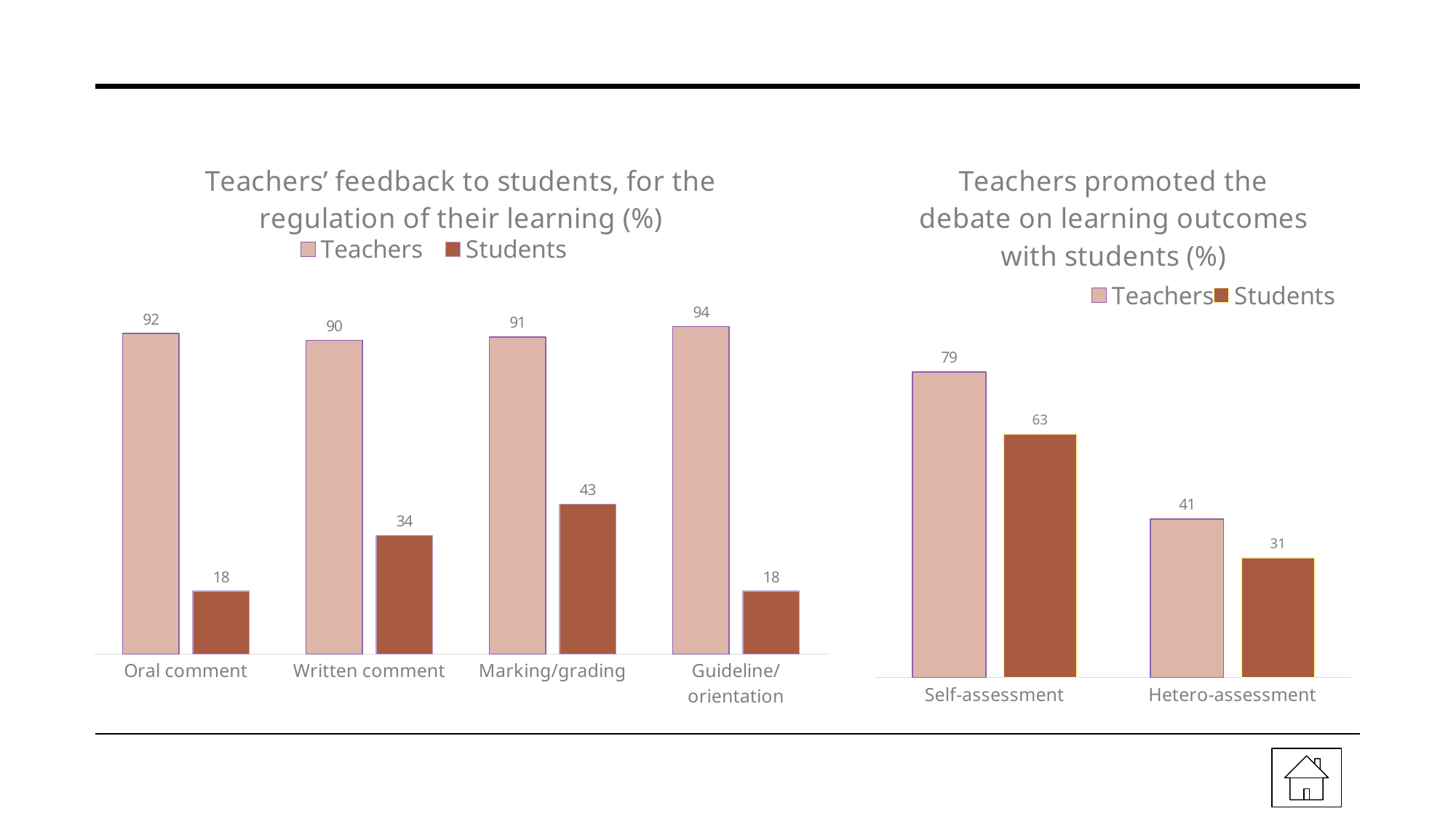
In the chart 'Teachers promoted the debate on learning outcomes with students (%)', what is the difference between the Teachers and Students values for Self-assessment? 16 In the chart 'Teachers' feedback to students, for the regulation of their learning (%)', what is the difference between the Teachers and Students values for Written comment? 56 In the chart 'Teachers' feedback to students, for the regulation of their learning (%)', how many categories are shown on the x axis? 4 In the chart 'Teachers' feedback to students, for the regulation of their learning (%)', which category has the highest Teachers value? Guideline/orientation In the chart 'Teachers promoted the debate on learning outcomes with students (%)', which is larger: the Students value for Self-assessment or the Teachers value for Hetero-assessment? Students value for Self-assessment In the chart 'Teachers' feedback to students, for the regulation of their learning (%)', what is the Students value for Marking/grading? 43 In the chart 'Teachers promoted the debate on learning outcomes with students (%)', what is the Teachers value for Hetero-assessment? 41 In the chart 'Teachers' feedback to students, for the regulation of their learning (%)', what is the Teachers value for Oral comment? 92 What type of chart is the chart on the right of the slide? Bar chart In the chart 'Teachers' feedback to students, for the regulation of their learning (%)', which category has the highest Students value? Marking/grading In the chart 'Teachers promoted the debate on learning outcomes with students (%)', what is the Students value for Self-assessment? 63 In the chart 'Teachers promoted the debate on learning outcomes with students (%)', how many series does the legend list? 2